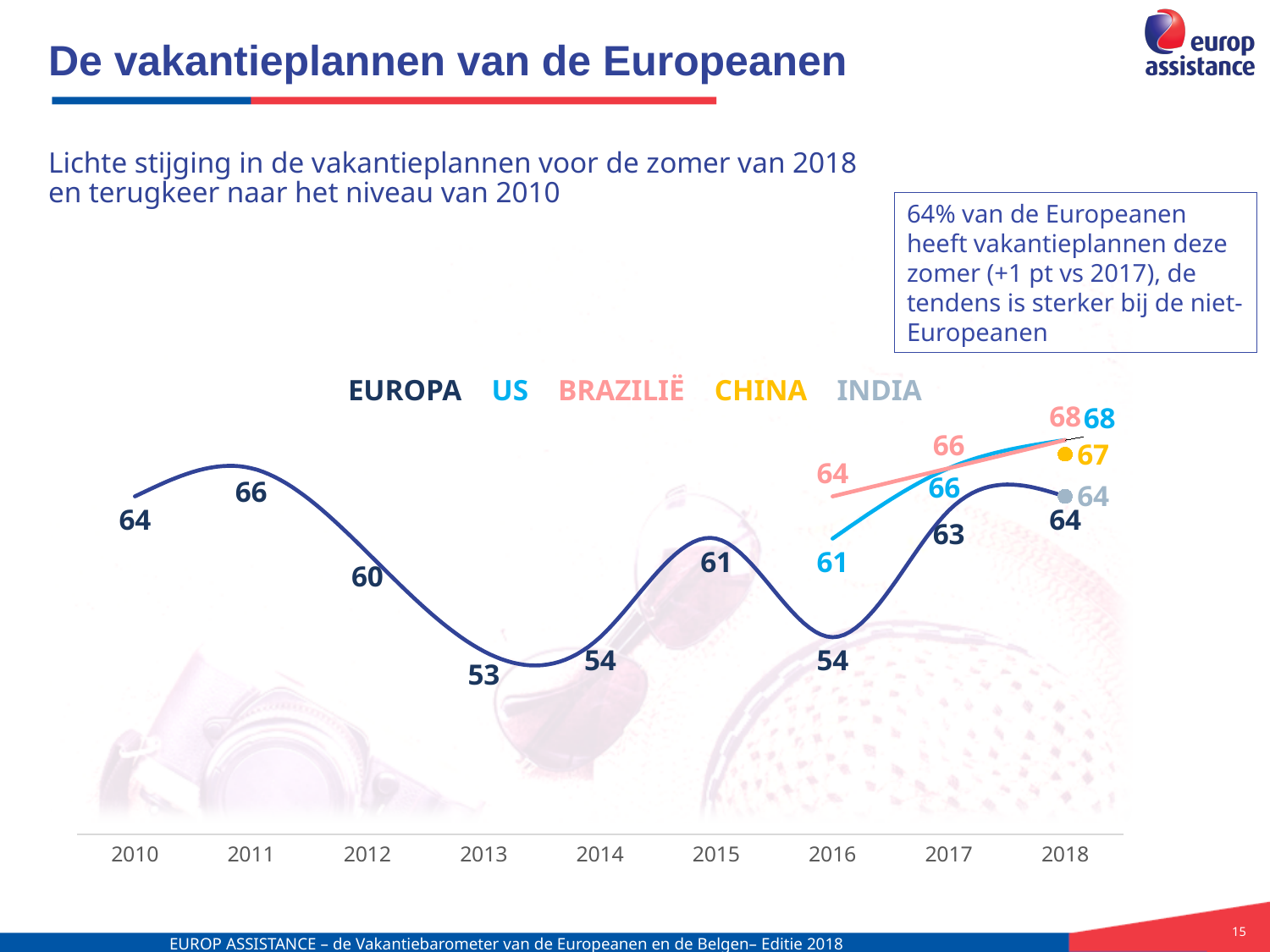
Which is larger in 2018, the value for US or the value for INDIA? US How many years are shown on the x axis? 9 What is the value for CHINA in 2018? 67 How many series does the legend list? 5 What is the value for US in 2016? 61 What kind of chart is shown on the slide? line chart What is the difference between the EUROPA values for 2011 and 2013? 13 What is the value for EUROPA in 2018? 64 What is the value for EUROPA in 2013? 53 Does the US series rise or fall from 2016 to 2018? rise In which year is the EUROPA value highest? 2011 In which year is the EUROPA value lowest? 2013